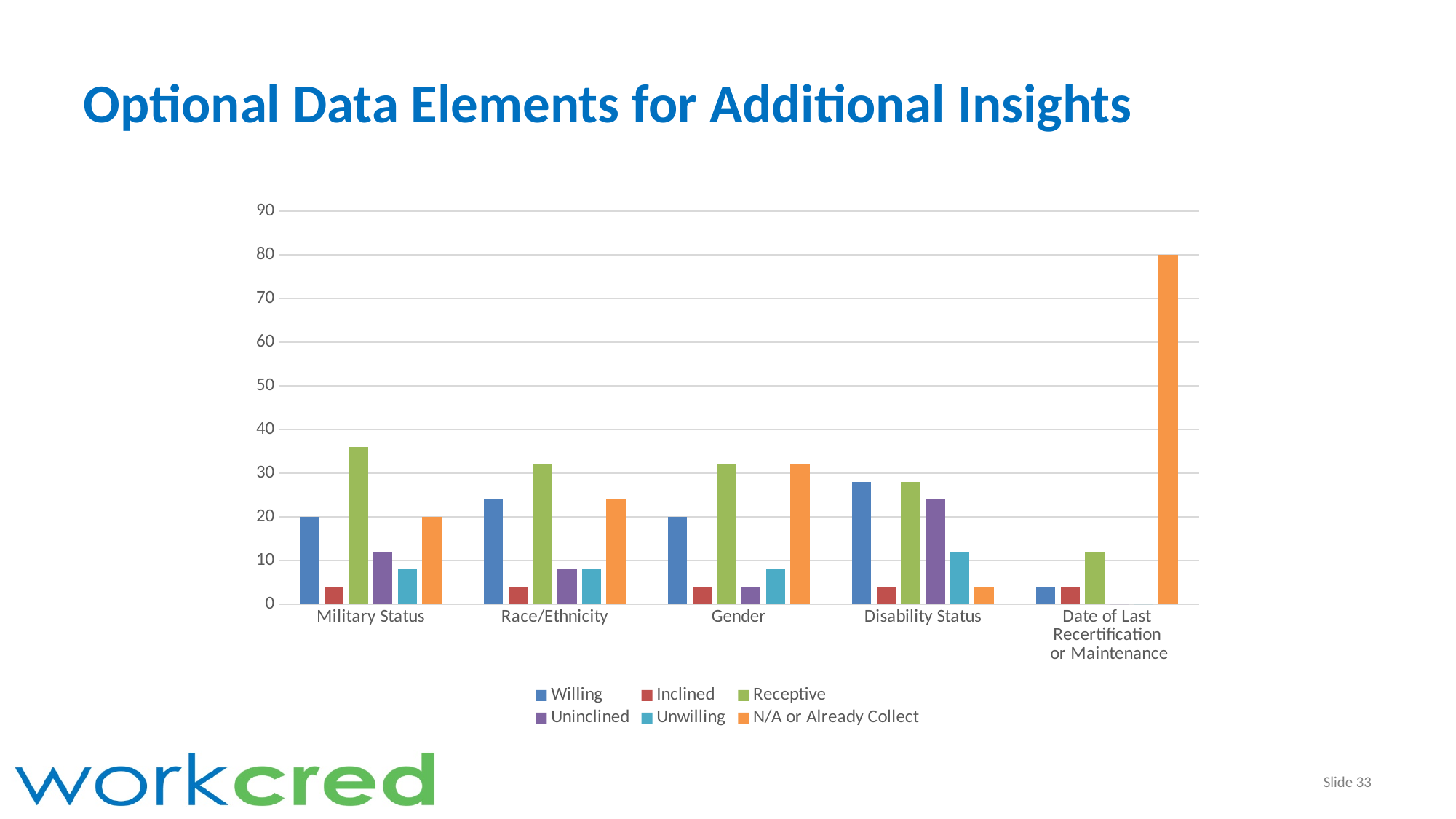
What kind of chart is shown on the slide? Bar chart How many categories are shown on the x axis? 5 What is the value of the N/A or Already Collect series for Date of Last Recertification or Maintenance? 80 What is the difference between the N/A or Already Collect value for Date of Last Recertification or Maintenance and the N/A or Already Collect value for Military Status? 60 Is the Willing value for Disability Status greater or less than 30? less Within the Military Status category, which series has the highest value? Receptive Which category has the tallest bar in the chart? Date of Last Recertification or Maintenance Is the Willing value for Disability Status greater or less than the Willing value for Gender? greater What is the value of the Willing series for Military Status? 20 What is the value of the Willing series for Gender? 20 Is the Receptive value for Military Status greater or less than 30? greater How many series does the legend list? 6